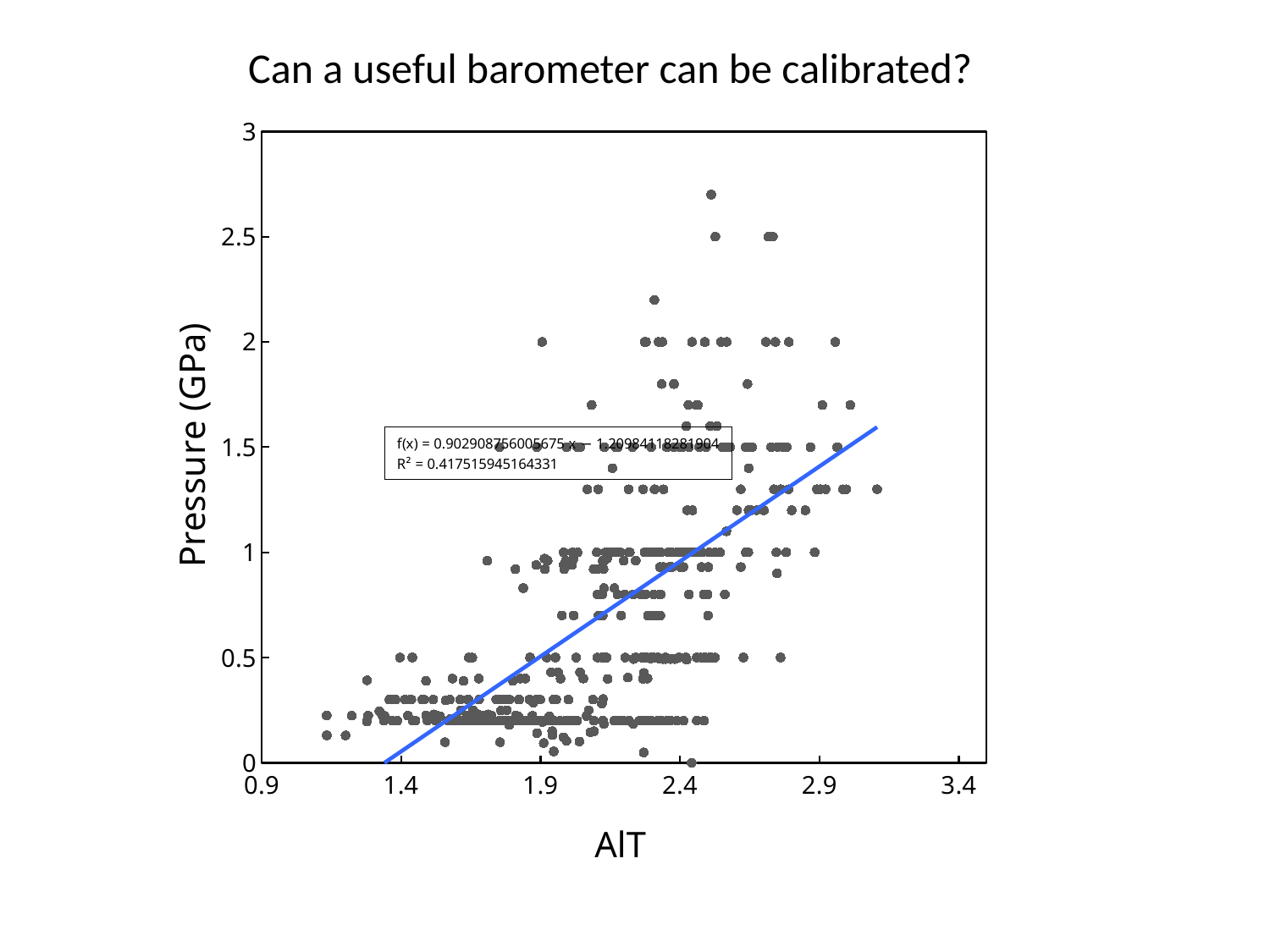
What is the trendline equation printed on the chart? f(x) = 0.902908756005675 x − 1.20984118281904 What is the minimum value shown on the x axis? 0.9 Is the pressure of the highest plotted point greater or less than 3 GPa? less Is the pressure of the highest plotted point greater or less than 2.5 GPa? greater What is the label of the x axis? AlT What is the label of the y axis? Pressure (GPa) What is the maximum value shown on the y axis? 3 What is the title of the chart? Can a useful barometer can be calibrated? What kind of chart is shown on the slide? scatter plot What R² value is printed on the chart? R² = 0.417515945164331 What is the maximum value shown on the x axis? 3.4 Does the trendline rise or fall as AlT increases? rise